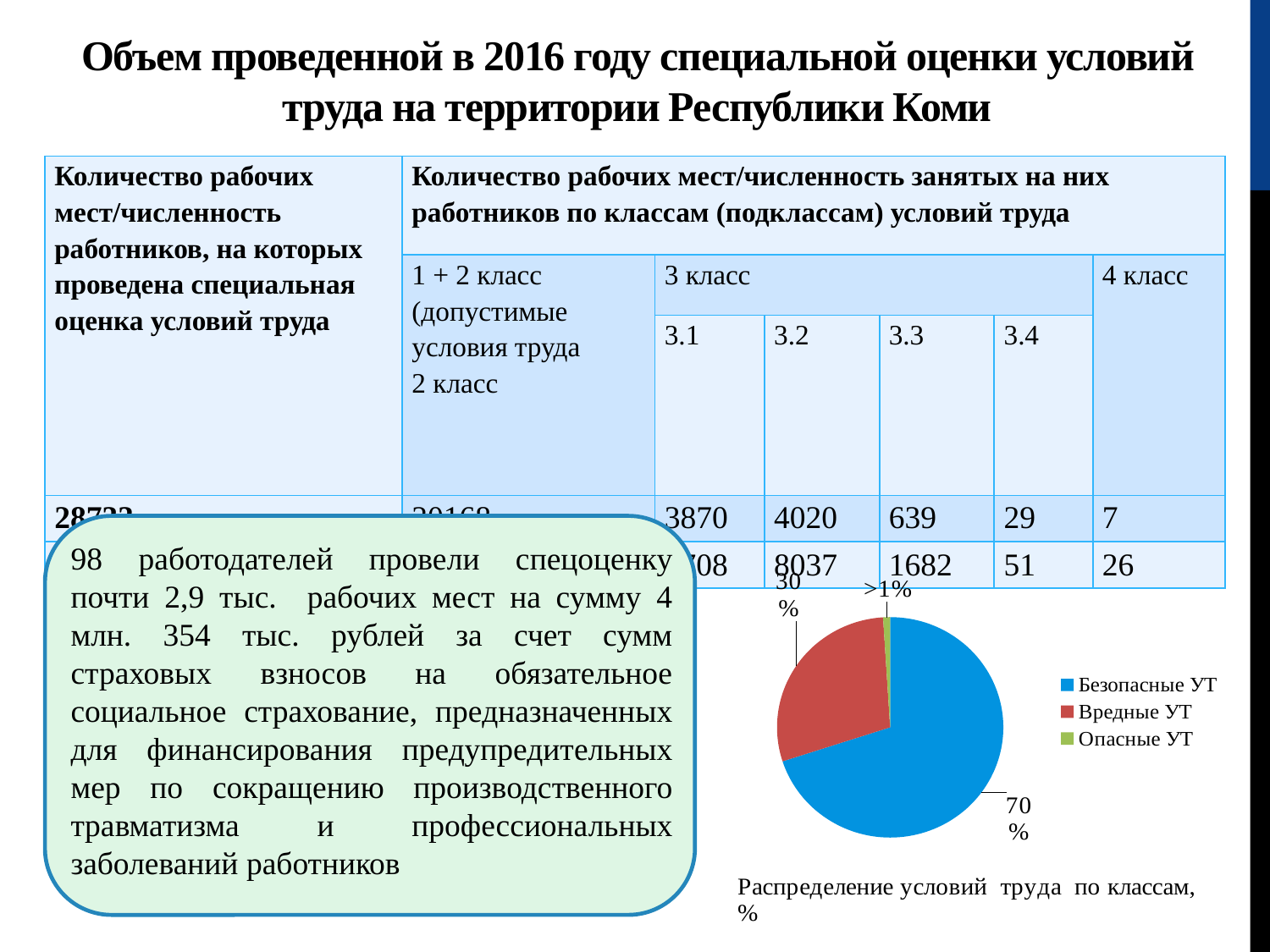
Which category has the smallest slice in the pie chart? Опасные УТ Which slice is larger in the pie chart, Безопасные УТ or Вредные УТ? Безопасные УТ How many entries does the pie chart legend list? 3 What kind of chart is shown on the slide? pie chart What share of the pie chart is labelled for Безопасные УТ? 70% How many slices does the pie chart have? 3 What share of the pie chart is labelled for Вредные УТ? 30% What label is shown on the pie chart for the Опасные УТ slice? >1% What is the caption written below the pie chart? Распределение условий труда по классам, % Which category has the largest slice in the pie chart? Безопасные УТ What colour is the Безопасные УТ slice in the pie chart? blue By how many percentage points does the Безопасные УТ slice exceed the Вредные УТ slice? 40%